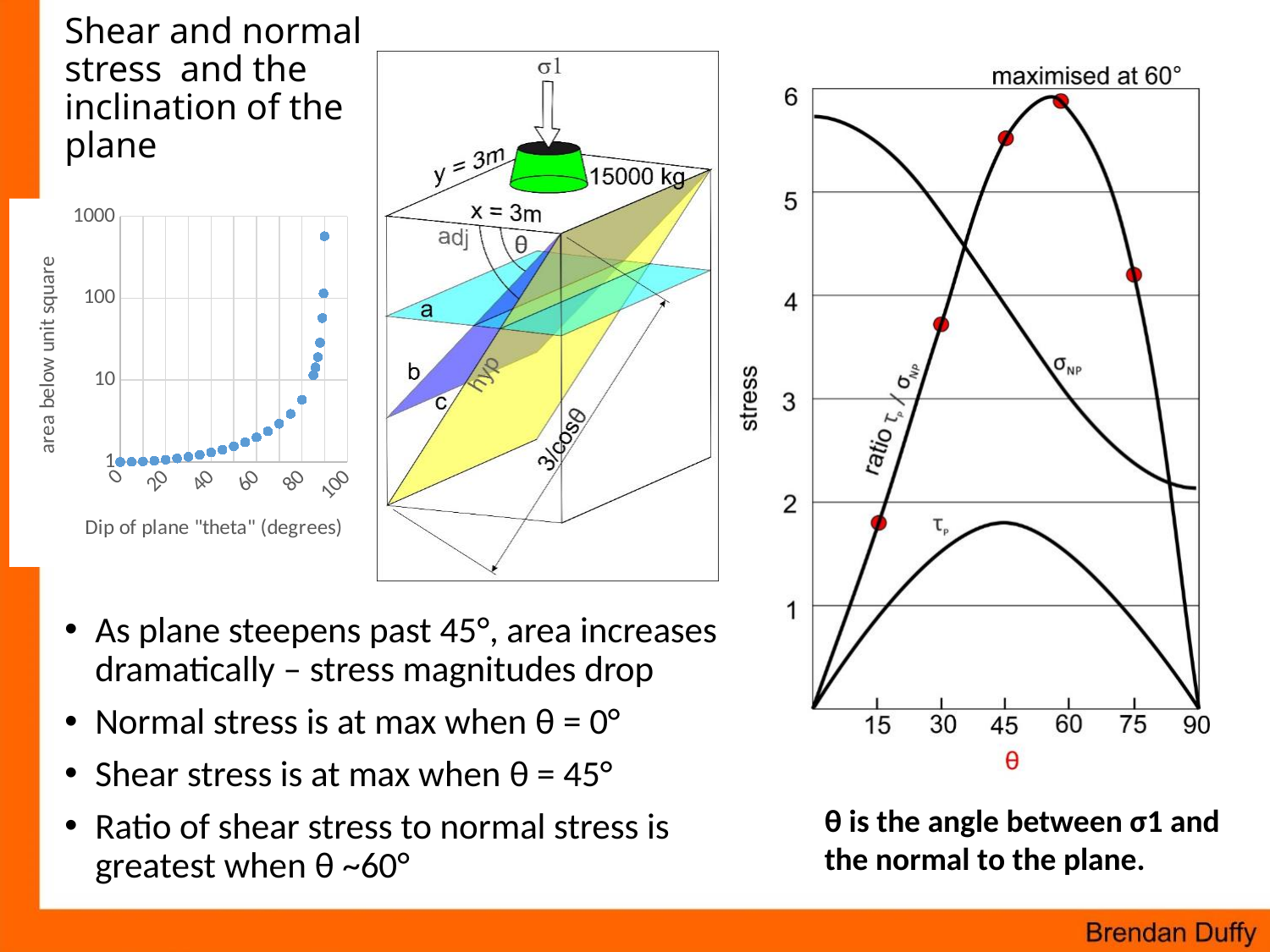
In the right chart of stress against θ, is the maximum value of τP greater or less than 2? less In the right chart of stress against θ, is the ratio τP/σNP at θ = 30 greater or less than 4? less In the left chart, what is the highest value shown on the y axis? 1000 In the left chart, is the value at a dip of 90 degrees greater or less than 100? greater In the left chart, do the values rise or fall as the dip of the plane increases? rise What kind of chart is the chart on the left titled with the y-axis 'area below unit square'? scatter chart In the right chart of stress against θ, how many curves are plotted? 3 In the right chart of stress against θ, at what angle θ is the ratio τP/σNP maximised? 60° In the left chart, what is the label of the x axis? Dip of plane "theta" (degrees) In the right chart of stress against θ, does σNP rise or fall as θ increases from 0 to 90? fall